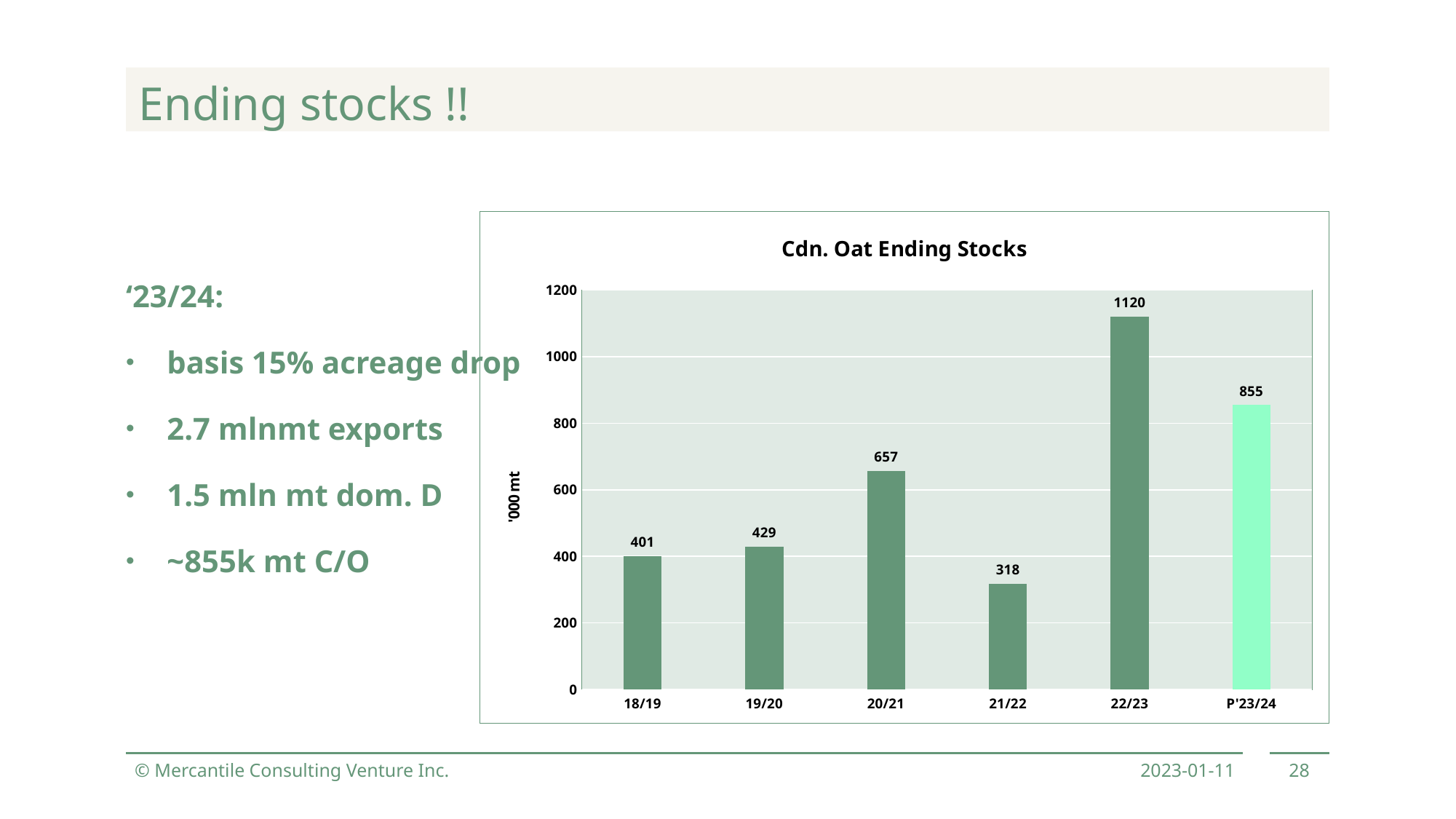
How many years (bars) are shown in the Cdn. Oat Ending Stocks chart? 6 What kind of chart is the Cdn. Oat Ending Stocks chart? bar chart What is the difference between the values for 22/23 and P'23/24? 265 What is the value for 21/22 in the Cdn. Oat Ending Stocks chart? 318 What is the value for 22/23 in the Cdn. Oat Ending Stocks chart? 1120 What is the difference between the values for 20/21 and 19/20? 228 Which is larger, the value for 18/19 or the value for 19/20? 19/20 What is the value for P'23/24 in the Cdn. Oat Ending Stocks chart? 855 Which bar in the chart is shown in a lighter colour than the others? P'23/24 Which year has the highest ending stocks in the chart? 22/23 Which year has the lowest ending stocks in the chart? 21/22 What is the label on the vertical axis of the chart? '000 mt